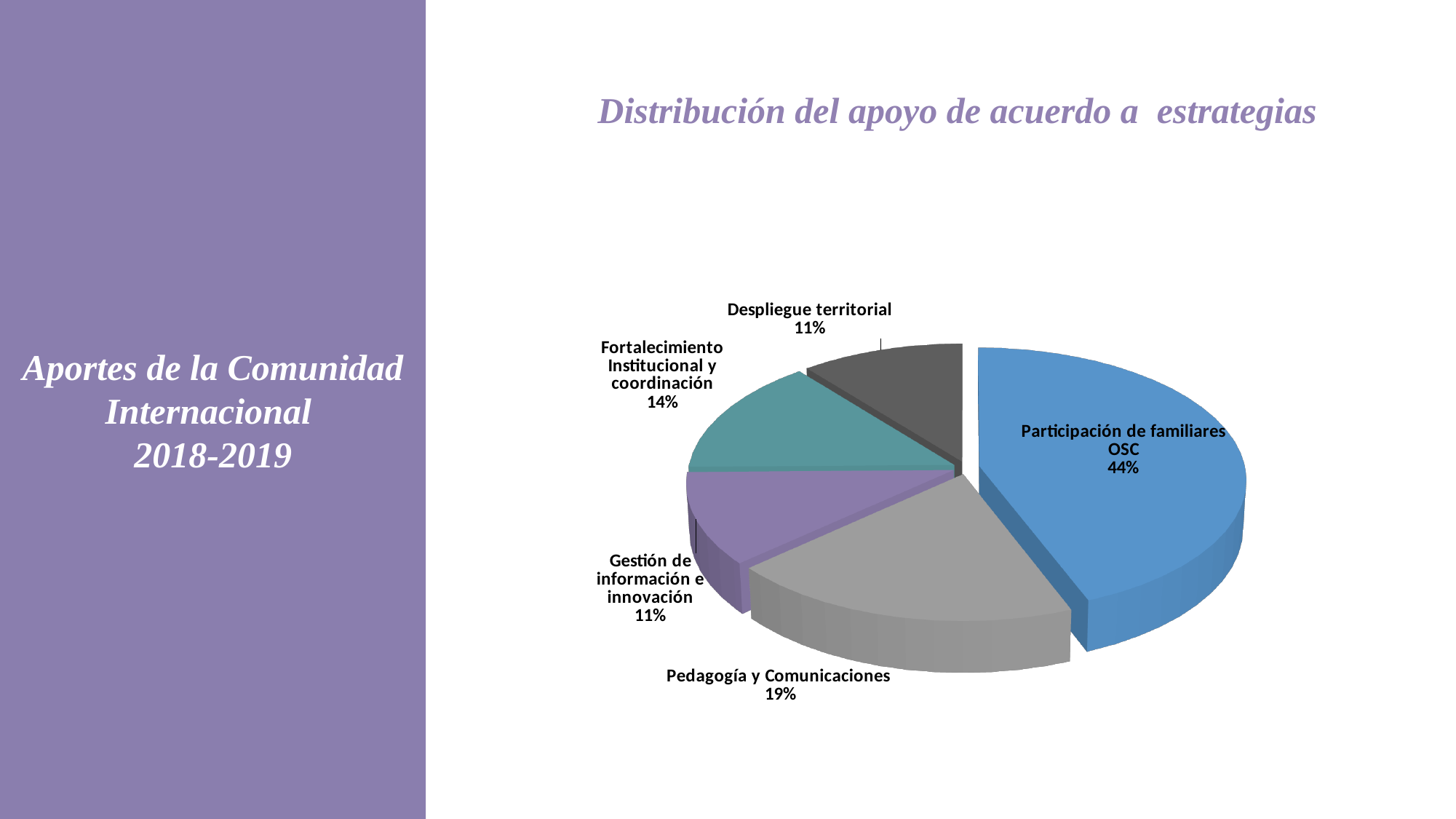
What is the title of the chart? Distribución del apoyo de acuerdo a estrategias What share of the pie does Participación de familiares OSC represent? 44% What share of the pie does Despliegue territorial represent? 11% What colour is the slice for Participación de familiares OSC? blue How many slices does the pie chart have? 5 What share of the pie does Gestión de información e innovación represent? 11% What kind of chart is shown on the slide? pie chart Which is larger, the share for Fortalecimiento Institucional y coordinación or the share for Despliegue territorial? Fortalecimiento Institucional y coordinación Which category has the largest slice of the pie? Participación de familiares OSC What is the difference in percentage points between Participación de familiares OSC and Pedagogía y Comunicaciones? 25 percentage points